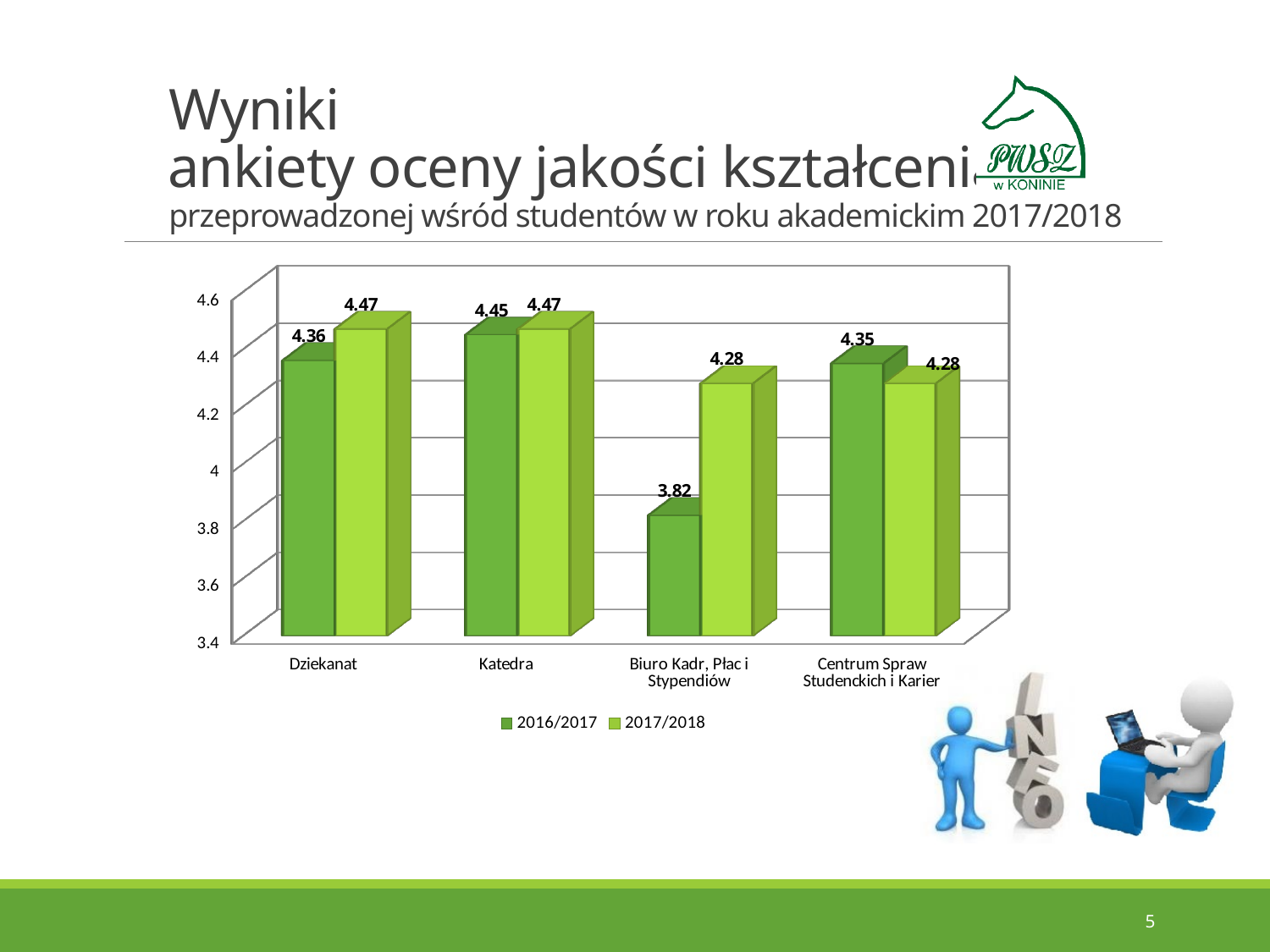
What kind of chart is shown on the slide? Bar chart How many categories are shown on the x axis of the chart? 4 What is the value for Centrum Spraw Studenckich i Karier in the 2016/2017 series? 4.35 Which is larger for Dziekanat: the 2016/2017 value or the 2017/2018 value? 2017/2018 Which is larger for Centrum Spraw Studenckich i Karier: the 2016/2017 value or the 2017/2018 value? 2016/2017 Which category has the highest value in the 2016/2017 series? Katedra What is the value for Biuro Kadr, Płac i Stypendiów in the 2017/2018 series? 4.28 What is the difference between the 2016/2017 and 2017/2018 values for Centrum Spraw Studenckich i Karier? 0.07 Which category has the lowest value in the 2016/2017 series? Biuro Kadr, Płac i Stypendiów What is the value for Dziekanat in the 2016/2017 series? 4.36 What is the difference between the 2017/2018 and 2016/2017 values for Biuro Kadr, Płac i Stypendiów? 0.46 How many series does the chart legend list? 2